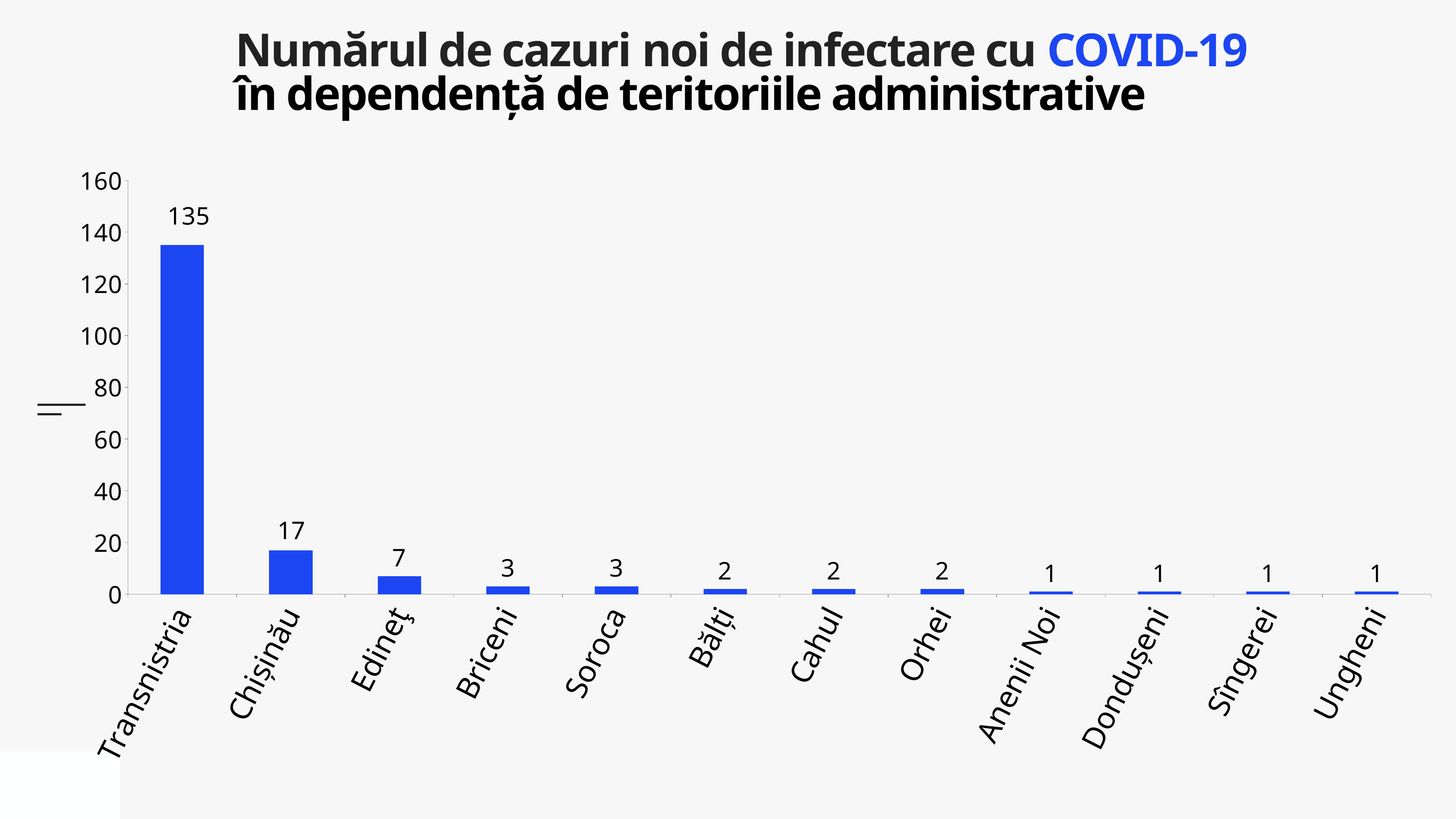
Do the values rise or fall from left to right along the x axis? fall What is the difference between the values for Transnistria and Chișinău? 118 Which category has the highest value? Transnistria Which is larger, the value for Edineț or the value for Briceni? Edineț What is the value for Edineț? 7 What is the value for Chișinău? 17 What is the value for Transnistria? 135 Is the value for Transnistria greater or less than 120? greater What is the value for Orhei? 2 How many categories are shown on the x axis? 12 What kind of chart is shown on the slide? bar chart What is the difference between the values for Chișinău and Edineț? 10